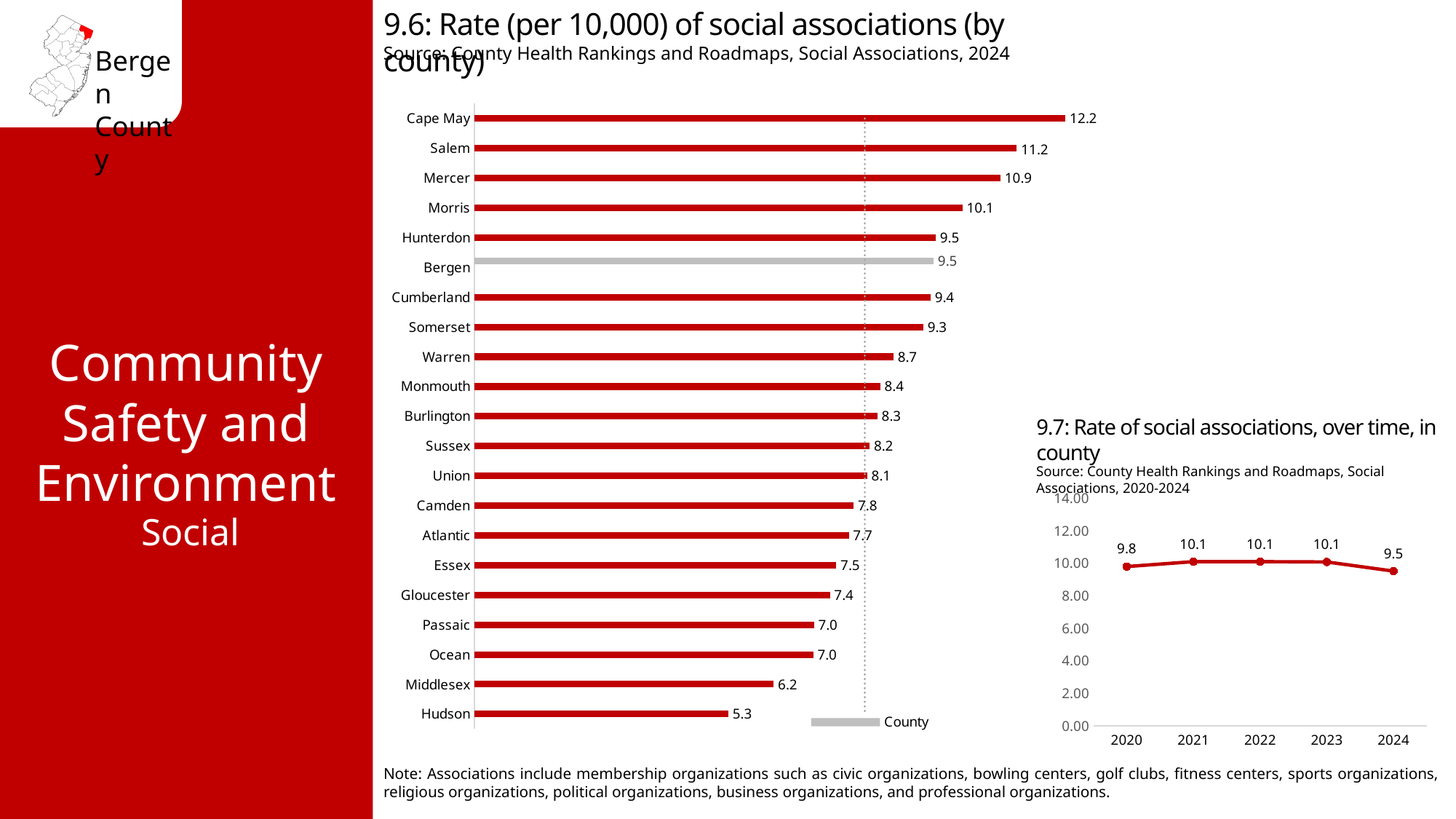
In chart 9.7 (rate of social associations over time), what is the difference between the 2023 and 2024 values? 0.6 In chart 9.6 (rate of social associations by county), which county has the highest rate? Cape May In chart 9.6 (rate of social associations by county), what is the value for Middlesex? 6.2 In chart 9.6 (rate of social associations by county), what is the difference between Cape May and Hudson? 6.9 In chart 9.6 (rate of social associations by county), which county has the lowest rate? Hudson What kind of chart is chart 9.7 (rate of social associations over time)? Line chart What kind of chart is chart 9.6 (rate of social associations by county)? Bar chart In chart 9.7 (rate of social associations over time), what is the value for 2024? 9.5 In chart 9.6 (rate of social associations by county), how many counties are shown? 21 In chart 9.6 (rate of social associations by county), which is larger, the value for Salem or the value for Mercer? Salem In chart 9.7 (rate of social associations over time), how many years are plotted? 5 In chart 9.6 (rate of social associations by county), what is the value for Bergen? 9.5